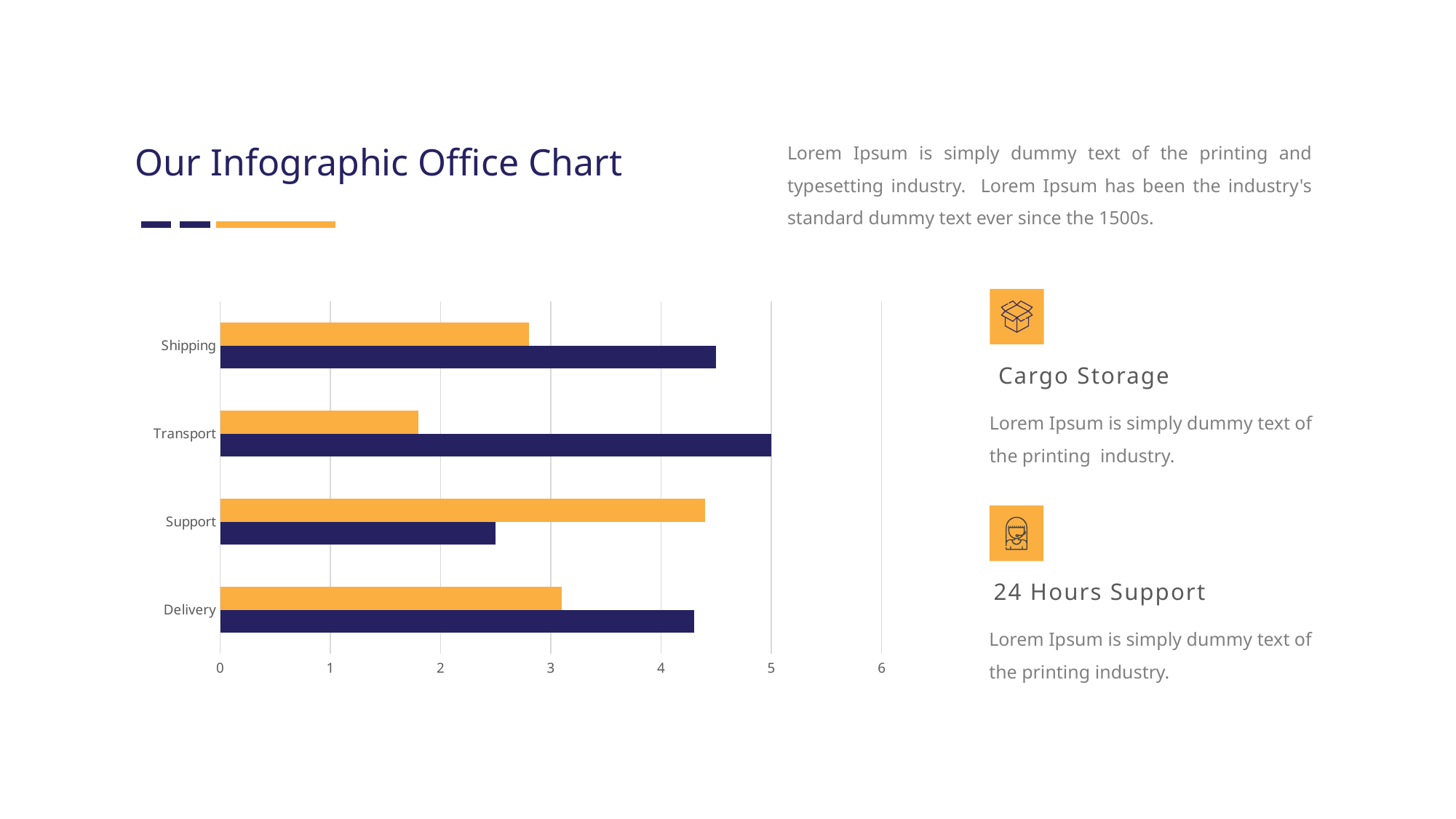
Is the value of the dark navy bar for Delivery greater or less than 4? greater What is the highest value labelled on the chart's horizontal axis? 6 Which category has the shortest orange bar? Transport Which category has the longest orange bar? Support For Support, which bar is longer, the orange bar or the dark navy bar? the orange bar How many categories are shown on the chart's vertical axis? 4 Which category has the longest dark navy bar? Transport Is the value of the orange bar for Shipping greater or less than 2? greater Is the value of the dark navy bar for Support greater or less than 3? less What is the value of the dark navy bar for Transport? 5 What kind of chart is shown on the slide? bar chart